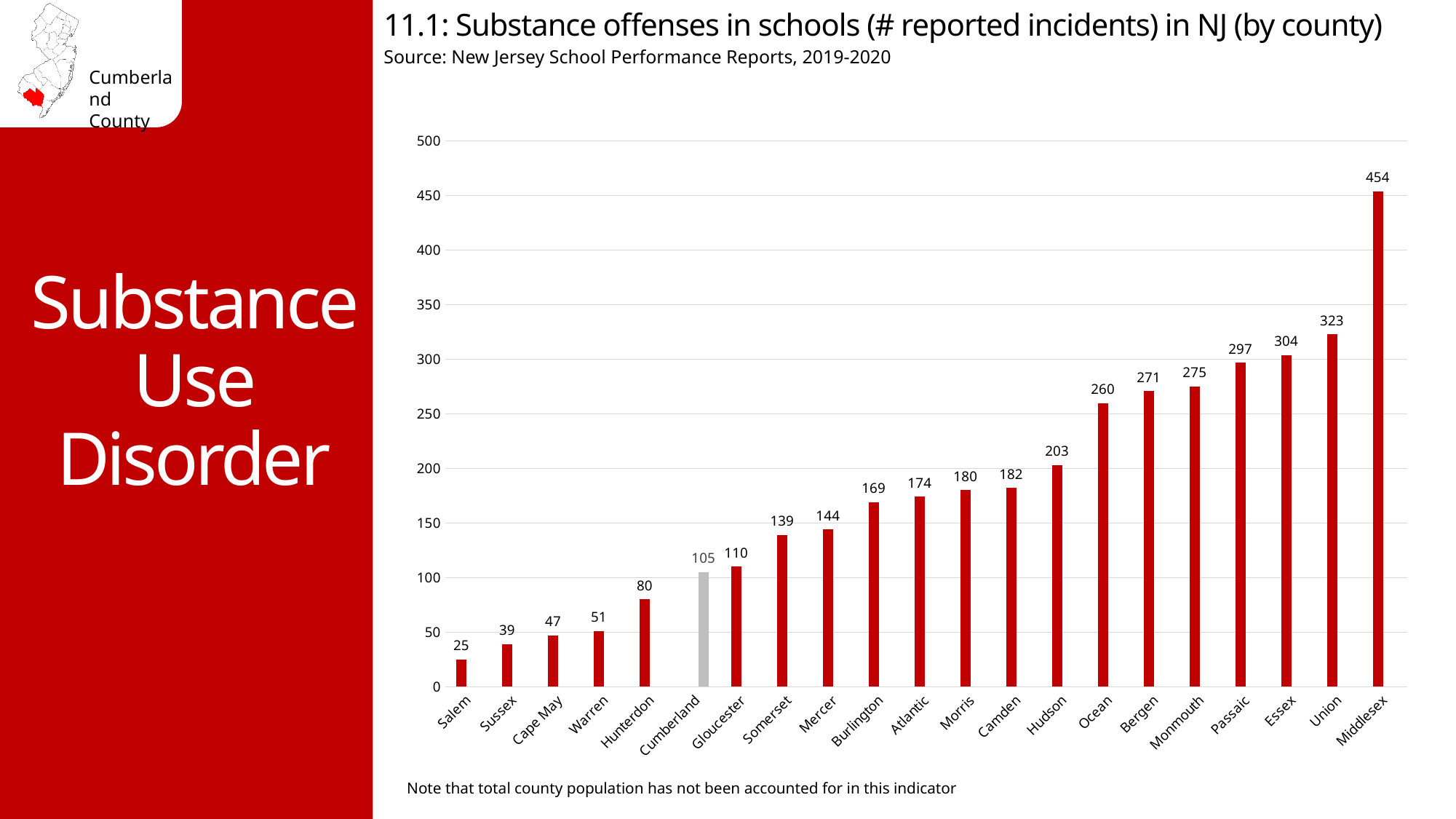
Is the value for Passaic greater or less than 300? less How many counties are shown on the chart? 21 How many reported incidents are shown for Hunterdon County? 80 Which county has the lowest number of reported substance offense incidents? Salem What kind of chart is shown on the slide? Bar chart What is the value shown for Middlesex County? 454 What is the difference between the values for Gloucester and Cumberland? 5 Which county's bar is shown in gray rather than red? Cumberland What is the difference between the values for Middlesex and Union? 131 Which county has the highest number of reported substance offense incidents? Middlesex What is the number of reported substance offense incidents in schools for Cumberland County? 105 Which county has a larger value, Ocean or Hudson? Ocean